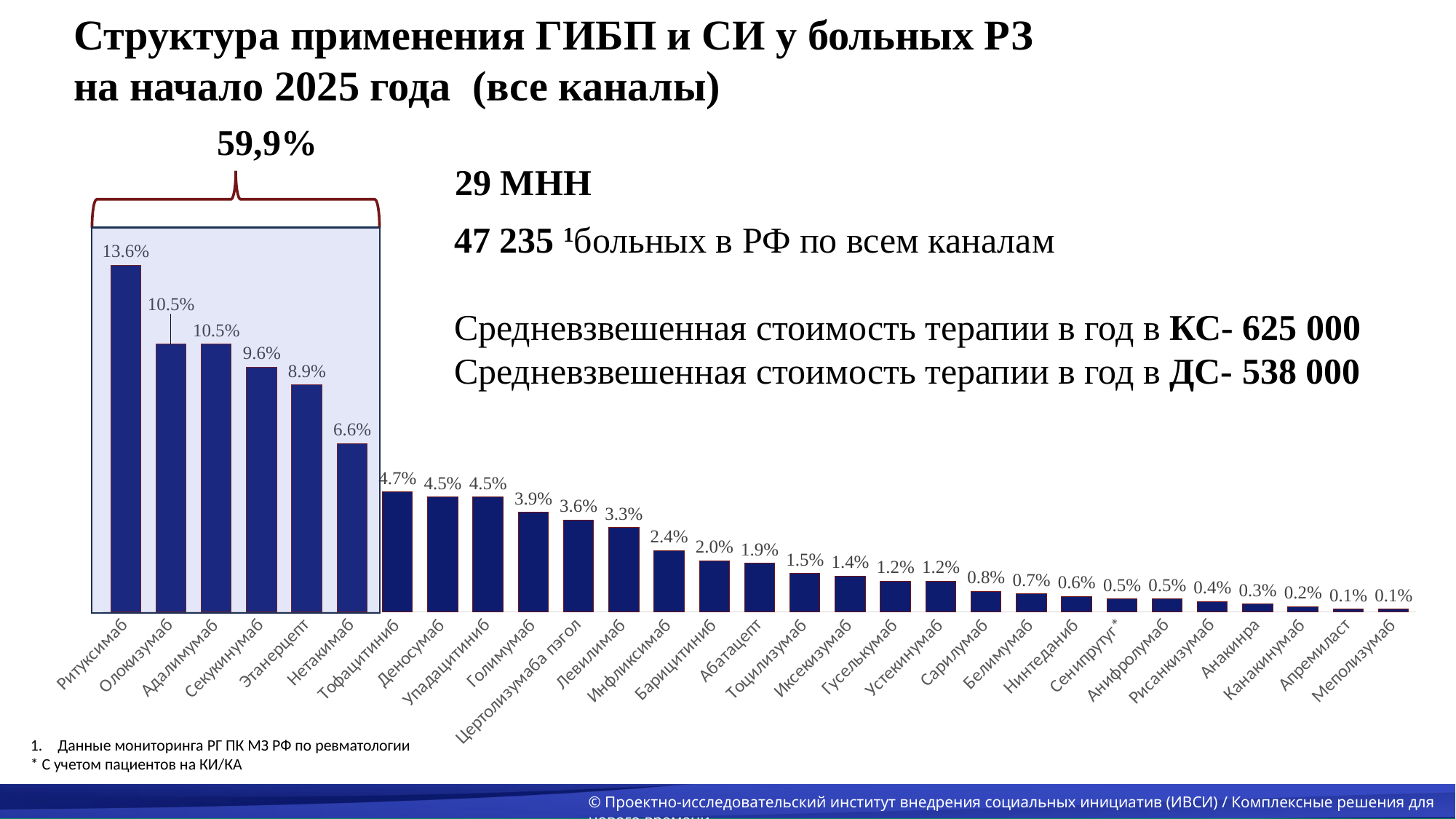
What is the value for Ритуксимаб? 13.6% What is the value for Тофацитиниб? 4.7% What combined share is indicated by the bracket above the first six highlighted bars? 59,9% What kind of chart is shown on the slide? bar chart What is the value for Инфликсимаб? 2.4% What is the difference between the values for Ритуксимаб and Нетакимаб? 7.0% Which category has the highest value? Ритуксимаб Do the values rise or fall from left to right along the x axis? fall How many categories are shown on the chart? 29 What is the lowest value shown on the chart? 0.1% What is the value for Анакинра? 0.3% Which is larger, the value for Секукинумаб or the value for Этанерцепт? Секукинумаб